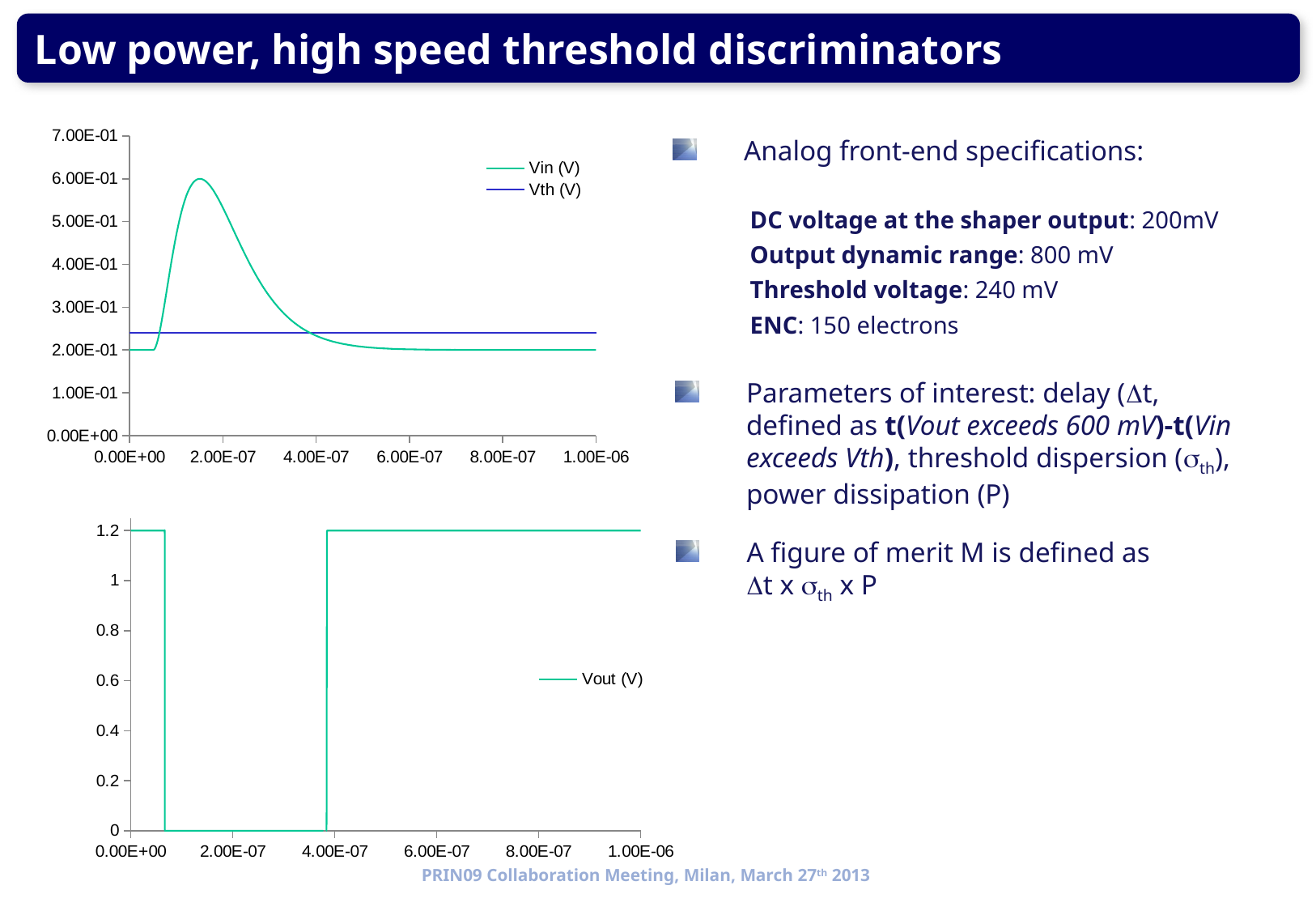
In the bottom chart, what is the high level of Vout (V)? 1.2 How many series does the legend of the top chart list? 2 In the bottom chart, what is the name of the plotted series? Vout (V) How many series does the legend of the bottom chart list? 1 In the top chart, is the peak value of Vin (V) greater or less than 5.00E-01? greater In the top chart, is the value of Vth (V) greater or less than 2.00E-01? greater In the top chart, which is larger: the peak of Vin (V) or the level of Vth (V)? the peak of Vin (V) What kind of chart is the top chart on the slide? line chart In the top chart, which two series are listed in the legend? Vin (V) and Vth (V) In the top chart, is the value of Vth (V) greater or less than 3.00E-01? less In the bottom chart, what is the low level of Vout (V)? 0 What kind of chart is the bottom chart on the slide? line chart